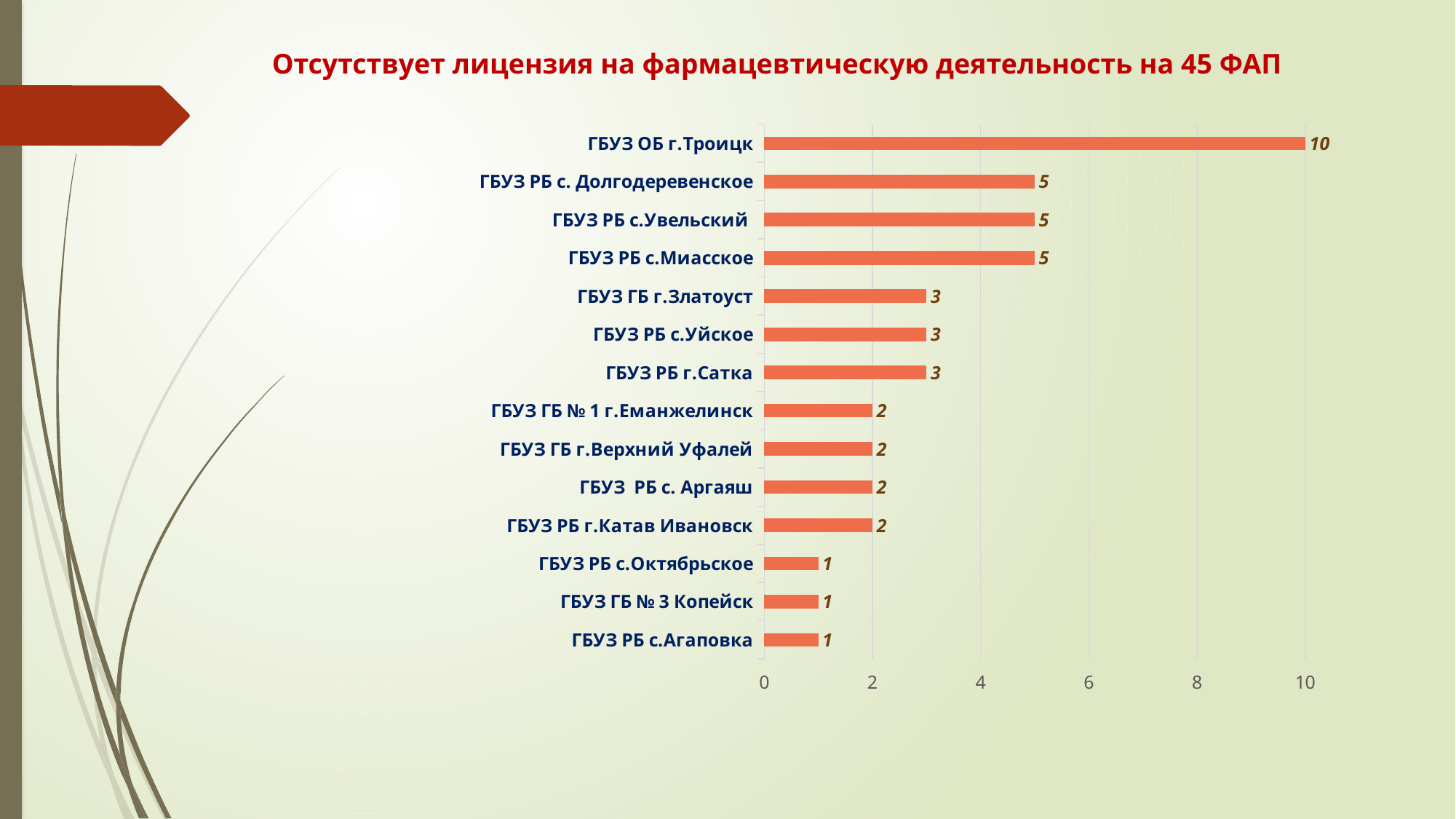
What is the value for ГБУЗ ГБ г.Златоуст? 3 How many categories are shown in the chart? 14 What is the title of the chart? Отсутствует лицензия на фармацевтическую деятельность на 45 ФАП What is the value for ГБУЗ ОБ г.Троицк? 10 What is the difference between the values for ГБУЗ ОБ г.Троицк and ГБУЗ РБ с. Долгодеревенское? 5 What is the difference between the values for ГБУЗ РБ с.Миасское and ГБУЗ РБ г.Сатка? 2 What kind of chart is shown on the slide? bar chart Which category has the highest value? ГБУЗ ОБ г.Троицк Which is larger, the value for ГБУЗ РБ с.Увельский or the value for ГБУЗ РБ с.Уйское? ГБУЗ РБ с.Увельский What is the value for ГБУЗ РБ с.Октябрьское? 1 Is the value for ГБУЗ ОБ г.Троицк greater or less than 8? greater What is the value for ГБУЗ ГБ № 1 г.Еманжелинск? 2